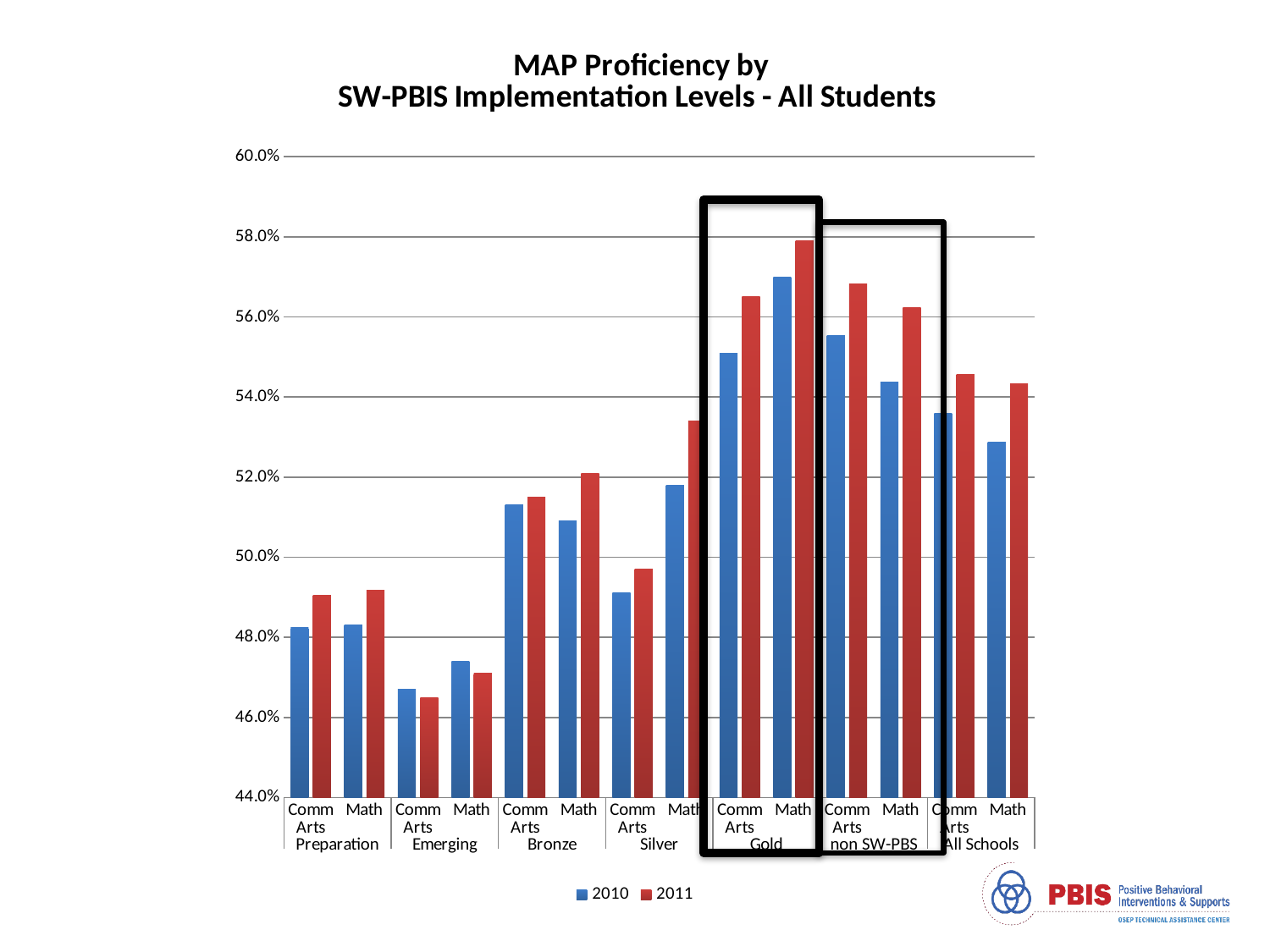
How many series does the legend list? 2 Which colour represents the 2011 series in the legend? red Which is larger, the 2011 Math value for Gold or the 2011 Math value for non SW-PBS? Gold Which implementation level group has the lowest proficiency values overall? Emerging Which is larger for Emerging in 2010, Comm Arts or Math? Math Is the 2011 Math value for Silver greater or less than 52.0%? greater Which bar is the highest in the chart? Gold Math 2011 Is the 2011 Math value for Gold greater or less than 56.0%? greater For the Gold group, are the 2011 values higher or lower than the 2010 values? higher What kind of chart is shown on the slide? bar chart Is the 2010 Comm Arts value for Emerging greater or less than 48.0%? less How many SW-PBIS implementation level groups are shown along the x axis? 7